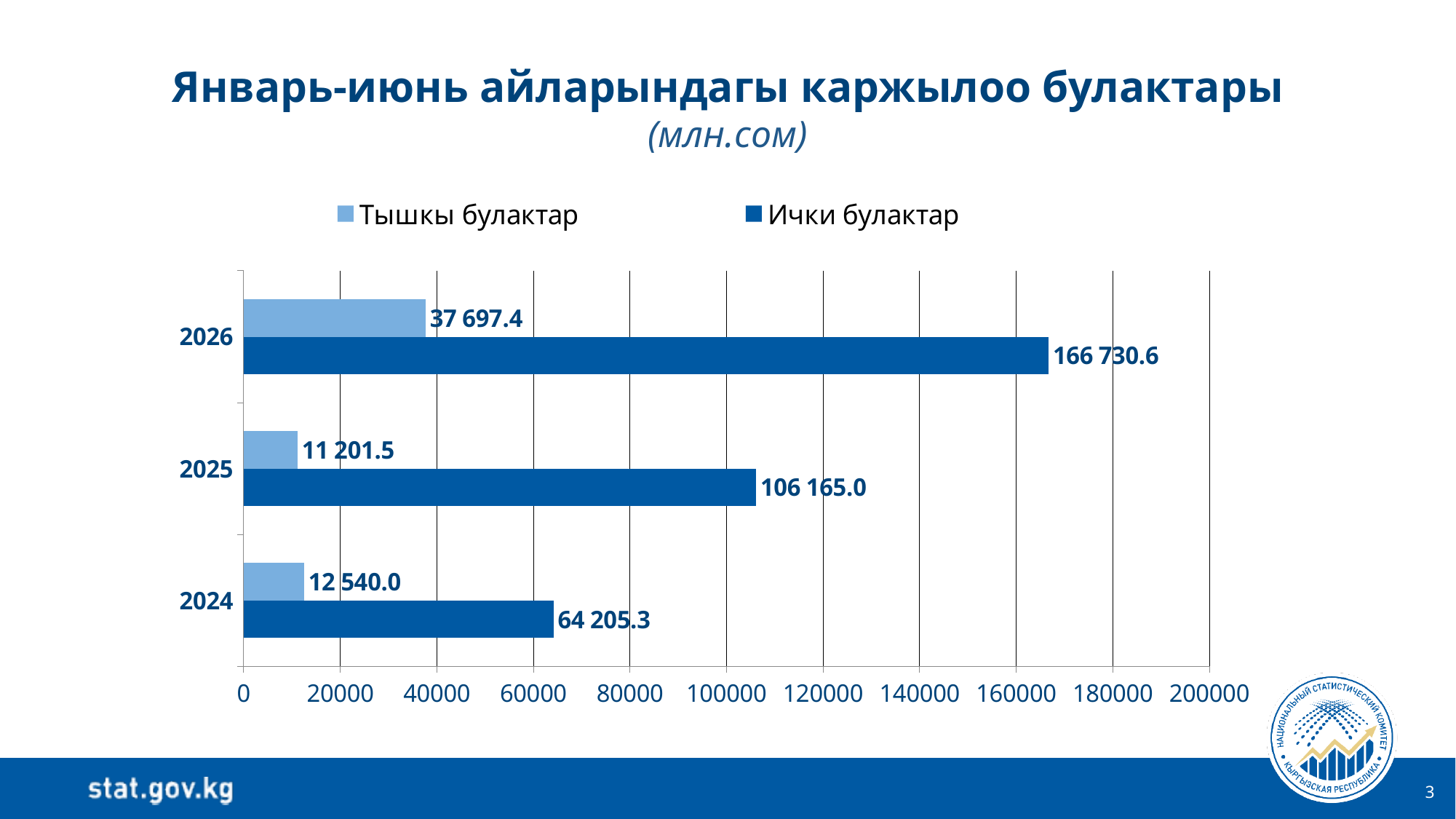
What is the difference between the Ички булактар values for 2026 and 2025? 60 565.6 Which year has the lowest value for Тышкы булактар? 2025 What is the value of Ички булактар for 2024? 64 205.3 How many years are shown on the chart? 3 What is the difference between Ички булактар and Тышкы булактар in 2026? 129 033.2 What kind of chart is shown on the slide? Bar chart What is the value of Тышкы булактар for 2026? 37 697.4 What is the value of Тышкы булактар for 2025? 11 201.5 Which is larger: Тышкы булактар in 2024 or Тышкы булактар in 2026? Тышкы булактар in 2026 Which year has the highest value for Ички булактар? 2026 How many series does the legend list? 2 What is the value of Ички булактар for 2026? 166 730.6